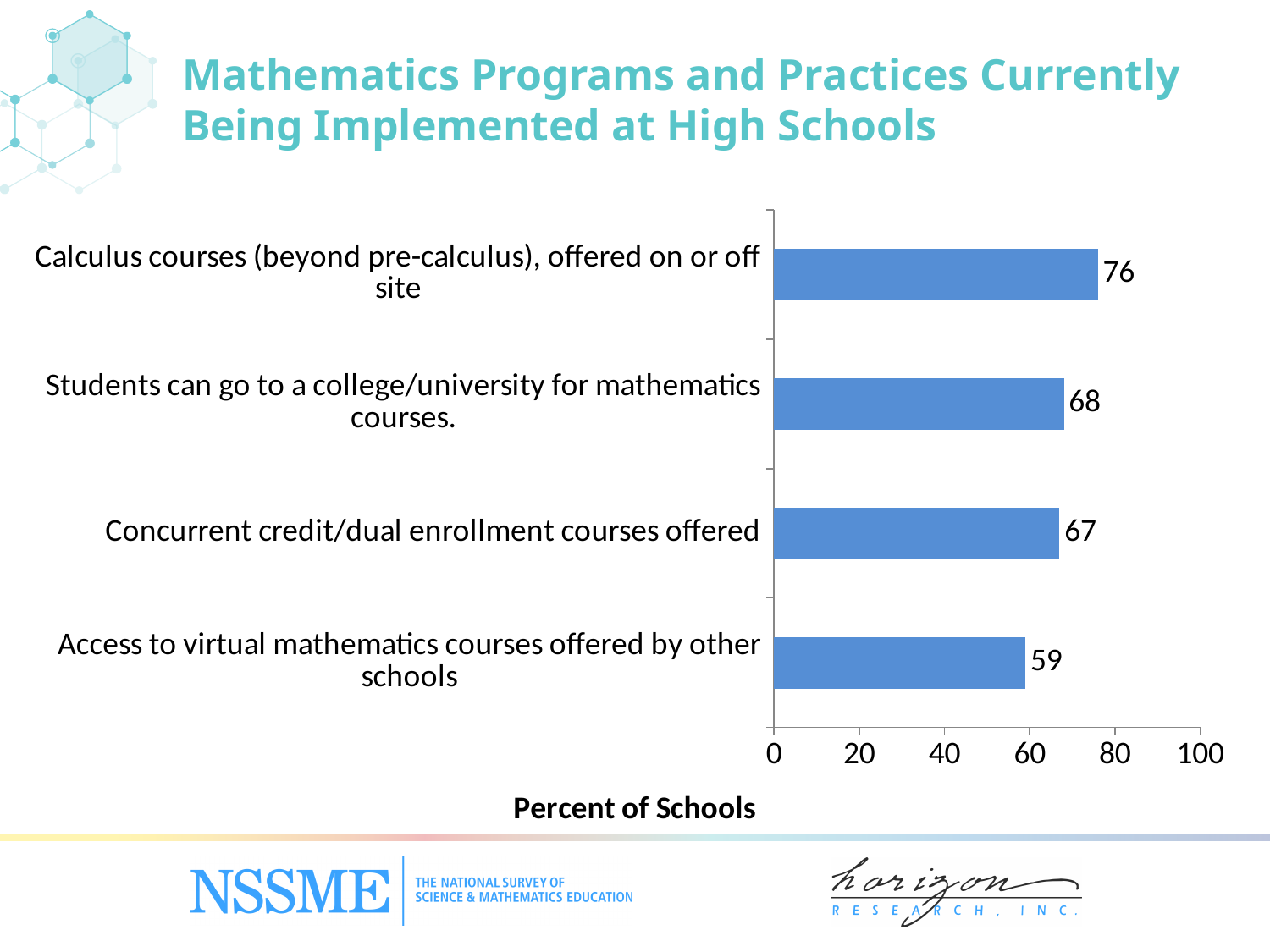
What percent of schools offer calculus courses (beyond pre-calculus), on or off site? 76 Which program or practice has the highest percent of schools? Calculus courses (beyond pre-calculus), offered on or off site What percent of schools have access to virtual mathematics courses offered by other schools? 59 How many programs or practices are shown in the chart? 4 What is the difference in percent of schools between calculus courses offered on or off site and access to virtual mathematics courses offered by other schools? 17 Is the value for concurrent credit/dual enrollment courses offered greater or less than 80? less Which is larger: the percent of schools where students can go to a college/university for mathematics courses, or the percent with access to virtual mathematics courses offered by other schools? Students can go to a college/university for mathematics courses. Which program or practice has the lowest percent of schools? Access to virtual mathematics courses offered by other schools What kind of chart is shown on the slide? Bar chart What is the label of the horizontal axis? Percent of Schools What percent of schools report that students can go to a college/university for mathematics courses? 68 What percent of schools offer concurrent credit/dual enrollment courses? 67